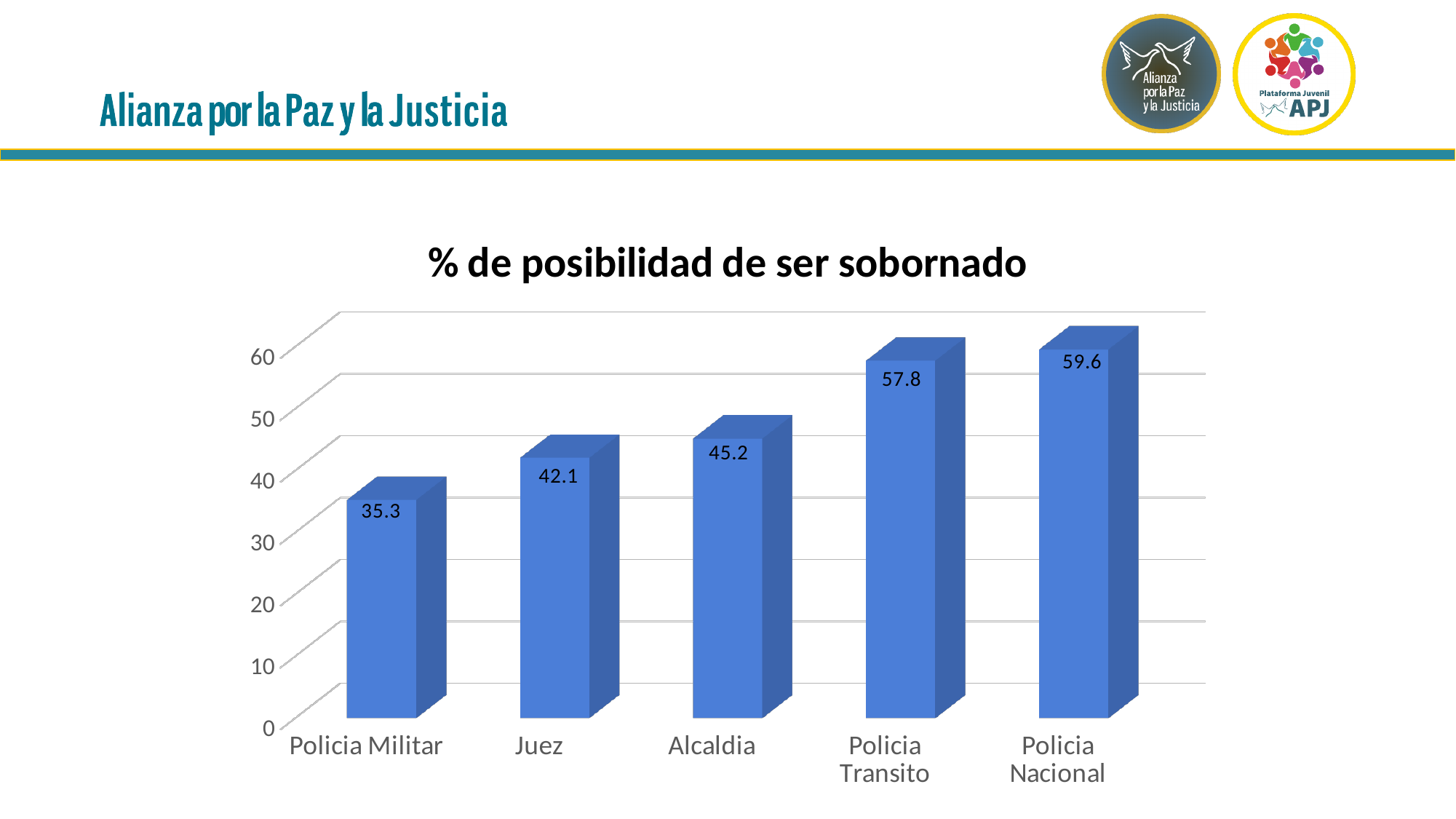
What is the title of the chart? % de posibilidad de ser sobornado What is the value for Policia Nacional? 59.6 What is the value for Policia Transito? 57.8 What is the value for Policia Militar? 35.3 What is the difference between the values for Policia Nacional and Policia Militar? 24.3 Which category has the highest value? Policia Nacional What kind of chart is shown on the slide? Bar chart What is the value for Juez? 42.1 How many categories are shown on the chart? 5 Which category has the lowest value? Policia Militar Which is larger, the value for Juez or the value for Alcaldia? Alcaldia What is the value for Alcaldia? 45.2